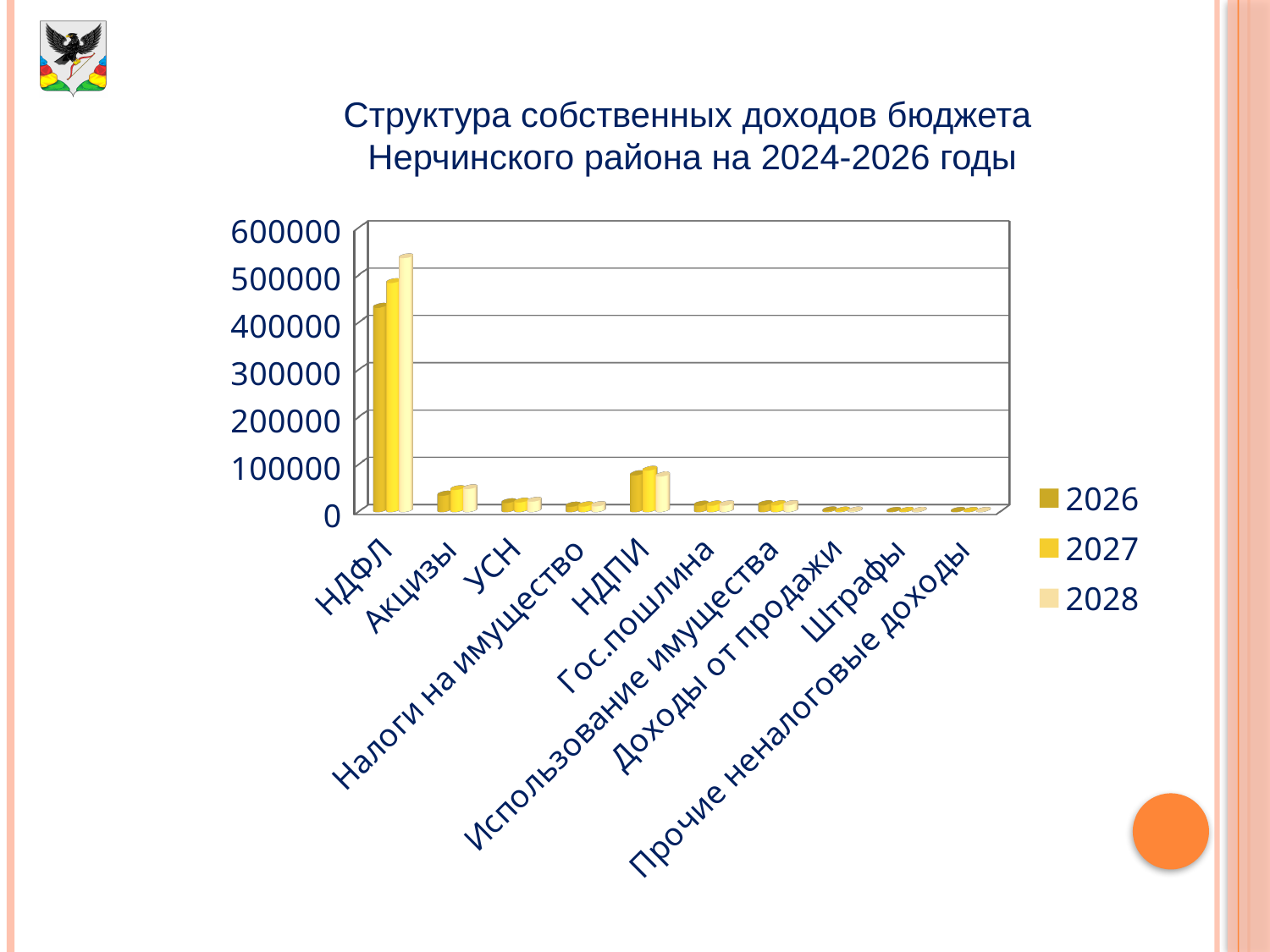
Is the value for УСН in 2026 greater or less than 100000? less How many series does the legend list? 3 Which is larger, the 2026 value for НДФЛ or the 2026 value for НДПИ? НДФЛ What is the title of the chart? Структура собственных доходов бюджета Нерчинского района на 2024-2026 годы What are the three series listed in the legend? 2026, 2027, 2028 Is the value for Акцизы in 2027 greater or less than 100000? less How many categories are shown on the x axis? 10 Do the values for НДФЛ rise or fall from 2026 to 2028? rise What kind of chart is shown on the slide? bar chart Is the value for НДФЛ in 2028 greater or less than 500000? greater Which category has the highest values in the chart? НДФЛ